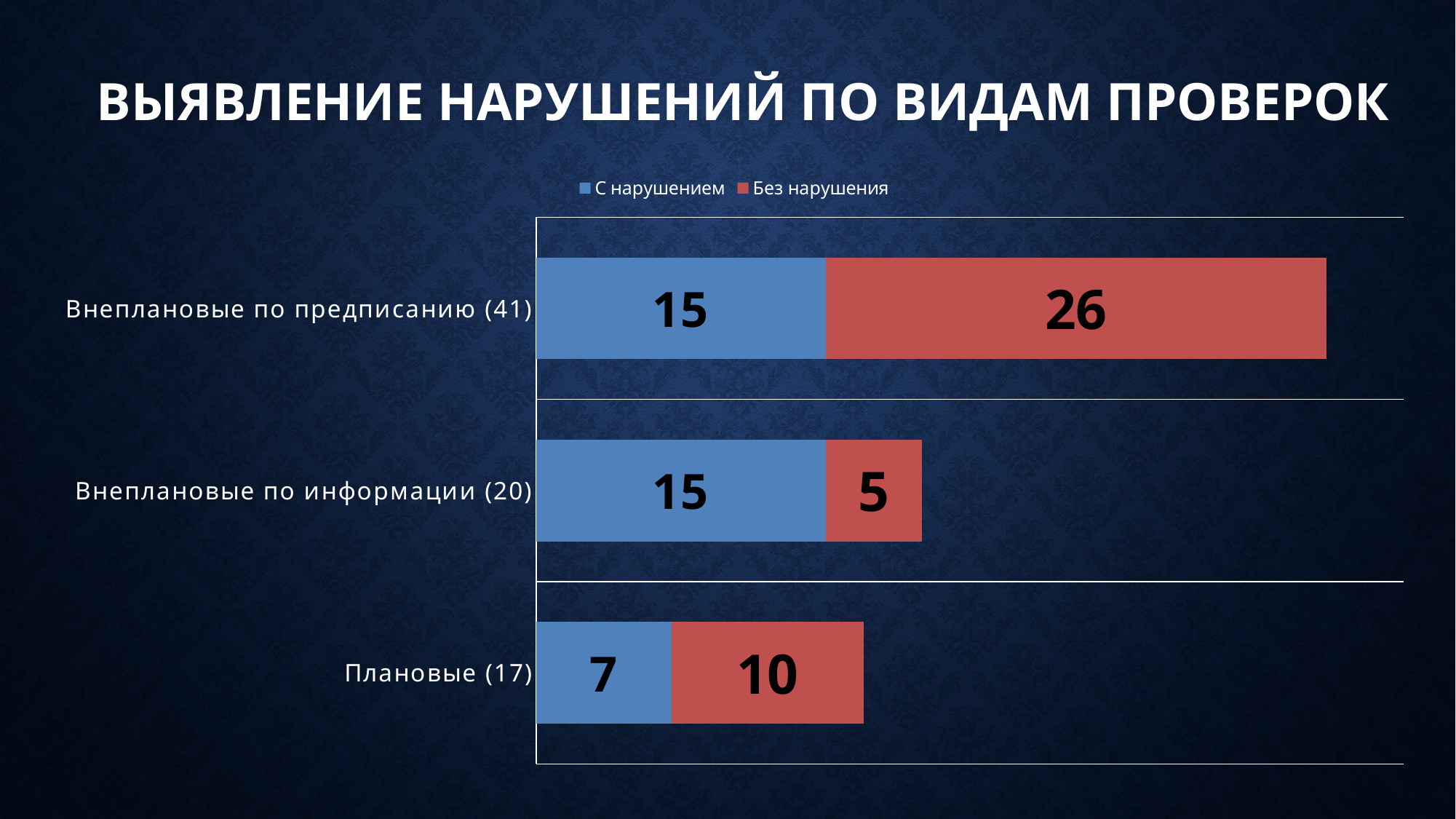
For "Плановые (17)", which is larger: "С нарушением" or "Без нарушения"? Без нарушения What is the value of "Без нарушения" for "Внеплановые по предписанию (41)"? 26 What is the value of "С нарушением" for "Плановые (17)"? 7 What is the value of "Без нарушения" for "Внеплановые по информации (20)"? 5 Which category has the highest value for "Без нарушения"? Внеплановые по предписанию (41) Which category has the lowest value for "С нарушением"? Плановые (17) How many categories are shown in the chart? 3 What is the value of "С нарушением" for "Внеплановые по предписанию (41)"? 15 How many series does the legend list? 2 What type of chart is shown on the slide? Stacked bar chart What is the total of the stacked bar for "Внеплановые по информации (20)"? 20 What is the difference between "Без нарушения" and "С нарушением" for "Внеплановые по предписанию (41)"? 11